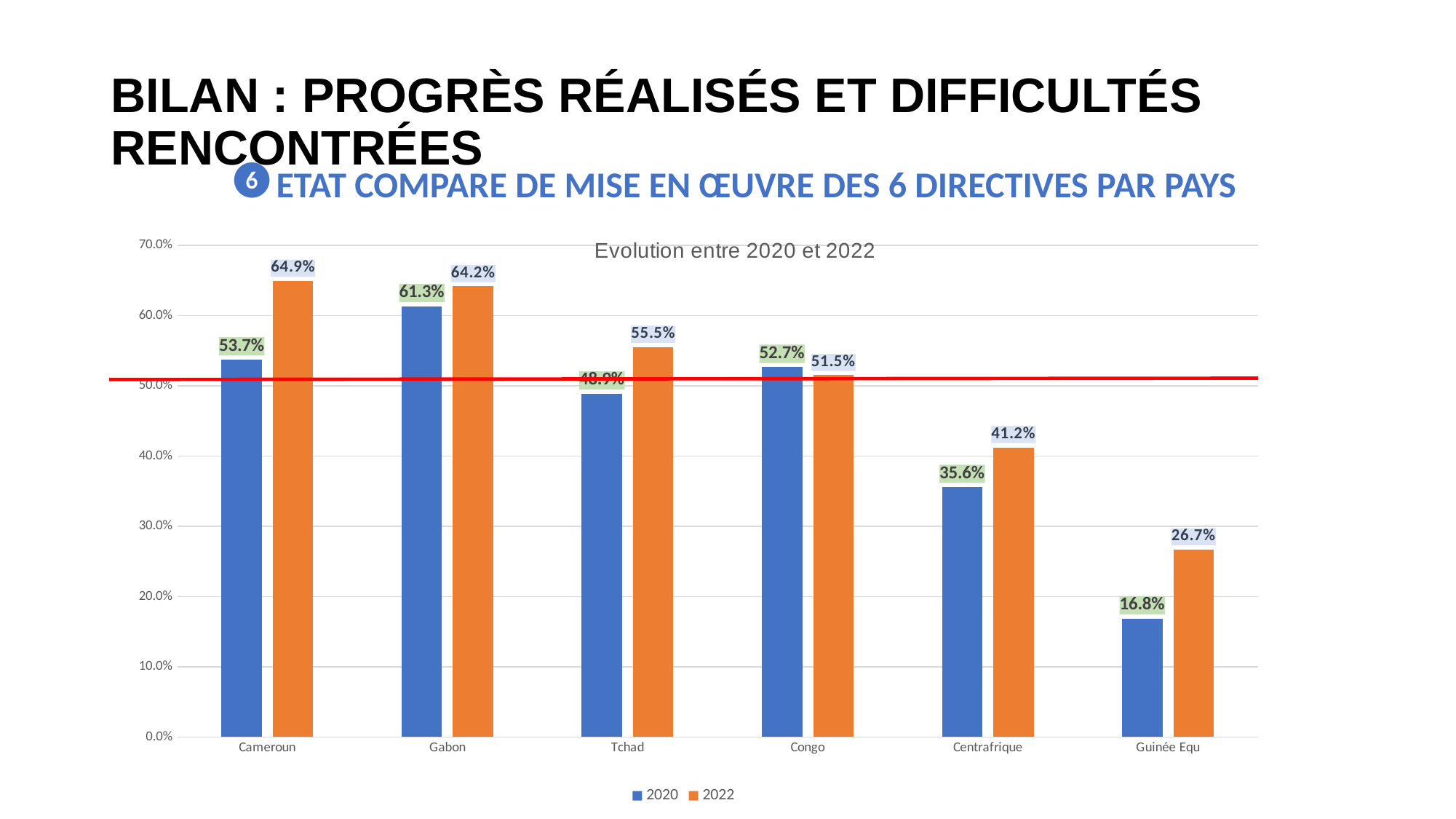
Is the 2022 value for Centrafrique greater or less than 40.0%? greater What is the 2020 value for Gabon? 61.3% What is the 2022 value for Cameroun? 64.9% What is the 2022 value for Guinée Equ? 26.7% Which country has the lowest 2020 value? Guinée Equ What is the title of the chart? Evolution entre 2020 et 2022 What kind of chart is shown? Bar chart How many countries are shown on the x axis? 6 Which is larger for Congo, the 2020 value or the 2022 value? 2020 Which country has the highest 2022 value? Cameroun What is the difference between the 2022 and 2020 values for Cameroun? 11.2% How many series does the legend list? 2